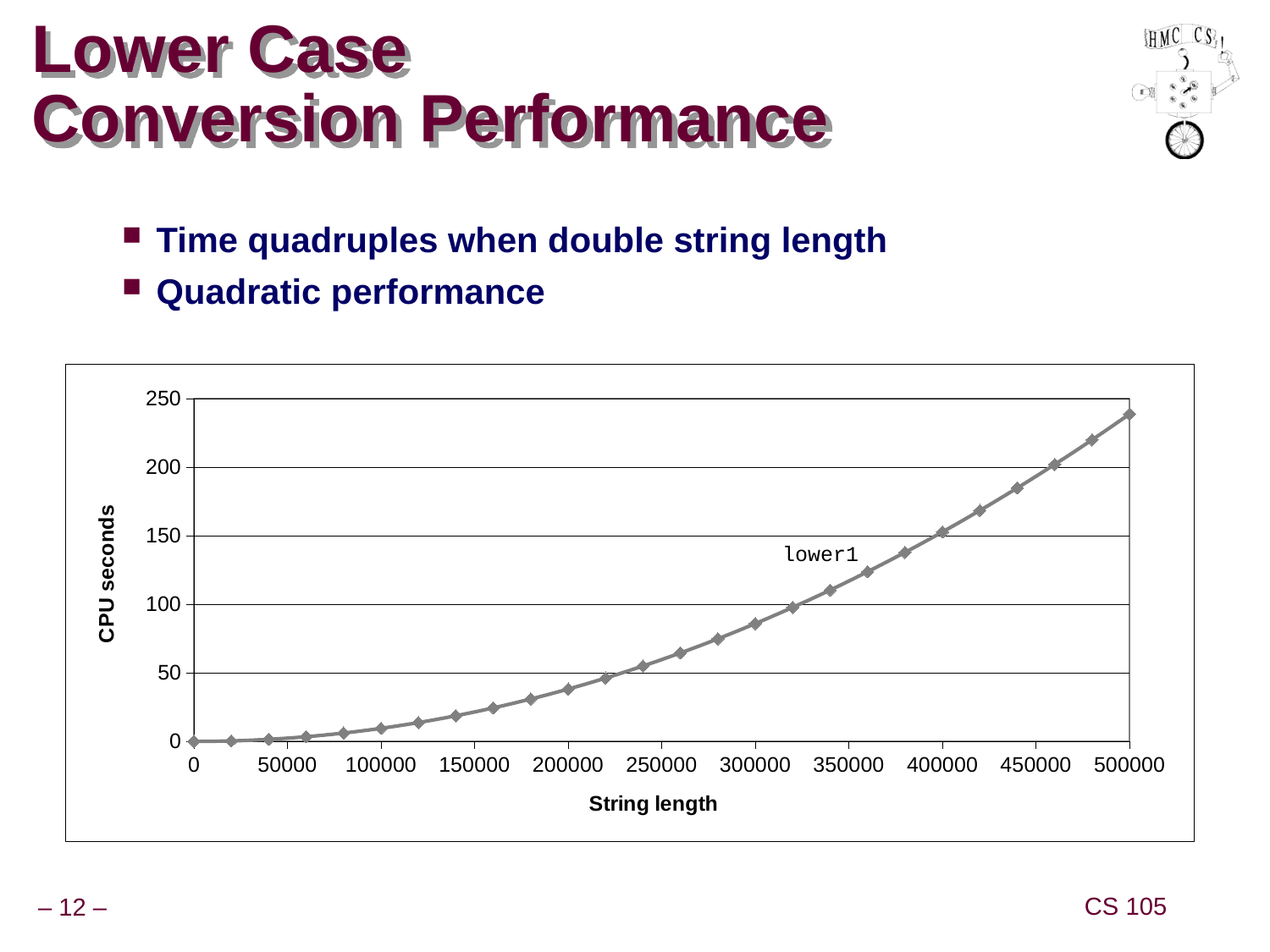
Which has the larger CPU seconds value: string length 100000 or string length 400000? 400000 Is the CPU seconds value at string length 500000 greater or less than 200? greater Is the CPU seconds value at string length 300000 greater or less than 100? less What is the name of the series plotted in the chart? lower1 Is the CPU seconds value at string length 200000 greater or less than 50? less How many series does the chart plot? 1 What is the label of the y axis? CPU seconds At which string length is the CPU seconds value highest? 500000 Do the CPU seconds rise or fall as string length increases? rise At which string length is the CPU seconds value lowest? 0 What kind of chart is shown on the slide? line chart